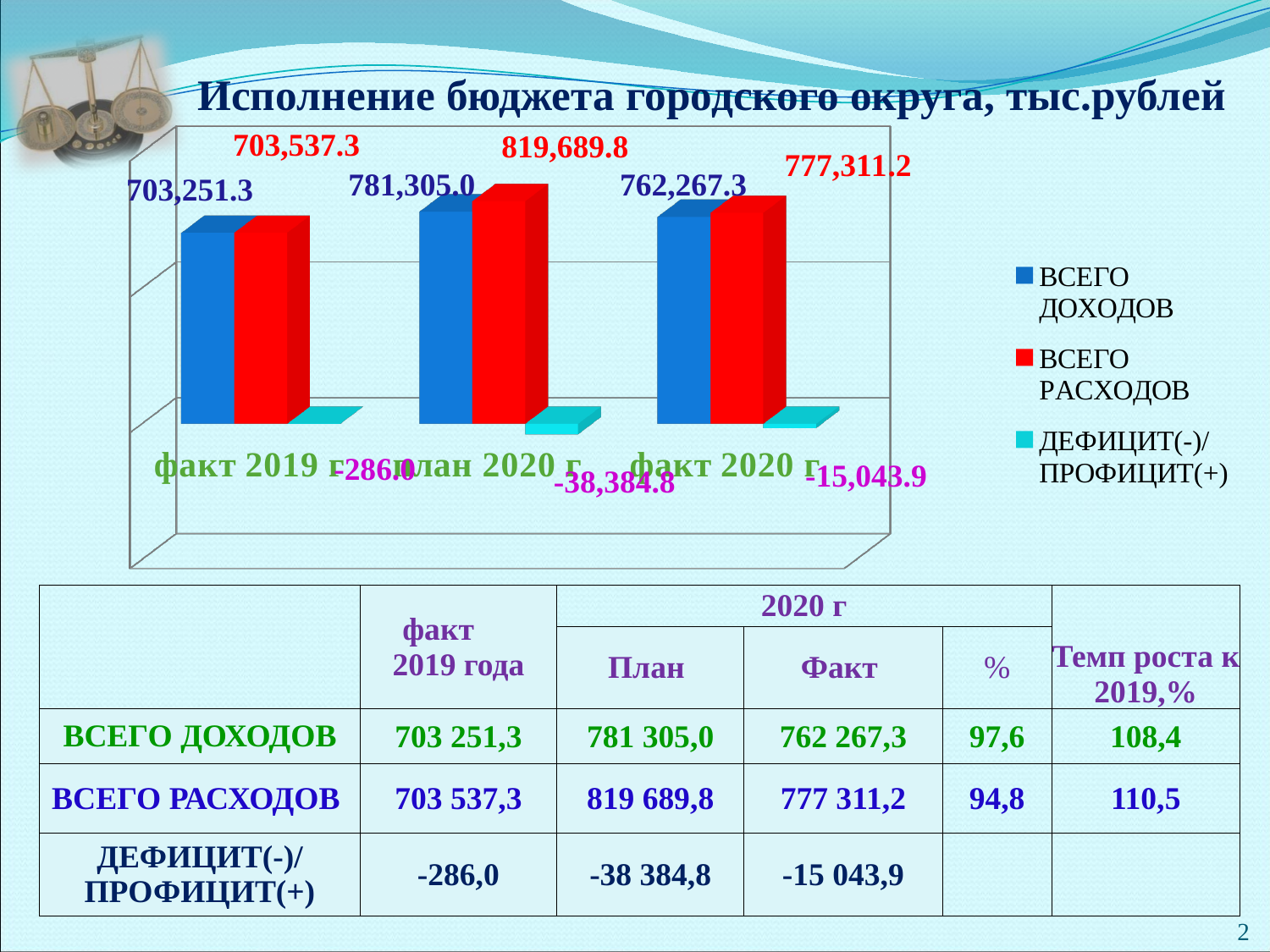
For which category is ВСЕГО РАСХОДОВ the highest? план 2020 г What is the difference between ВСЕГО РАСХОДОВ and ВСЕГО ДОХОДОВ for план 2020 г? 38,384.8 Which is larger: ВСЕГО РАСХОДОВ for план 2020 г or ВСЕГО РАСХОДОВ for факт 2020 г? план 2020 г How many series does the chart legend list? 3 What is the title of the chart? Исполнение бюджета городского округа, тыс.рублей What is the value of ВСЕГО РАСХОДОВ for план 2020 г? 819,689.8 What kind of chart is shown on the slide? bar chart What is the value of ВСЕГО ДОХОДОВ for факт 2019 г? 703,251.3 How many categories are shown on the x axis of the chart? 3 For which category is ВСЕГО ДОХОДОВ the lowest? факт 2019 г What is the value of ДЕФИЦИТ(-)/ПРОФИЦИТ(+) for факт 2020 г? -15,043.9 What is the value of ВСЕГО ДОХОДОВ for факт 2020 г? 762,267.3